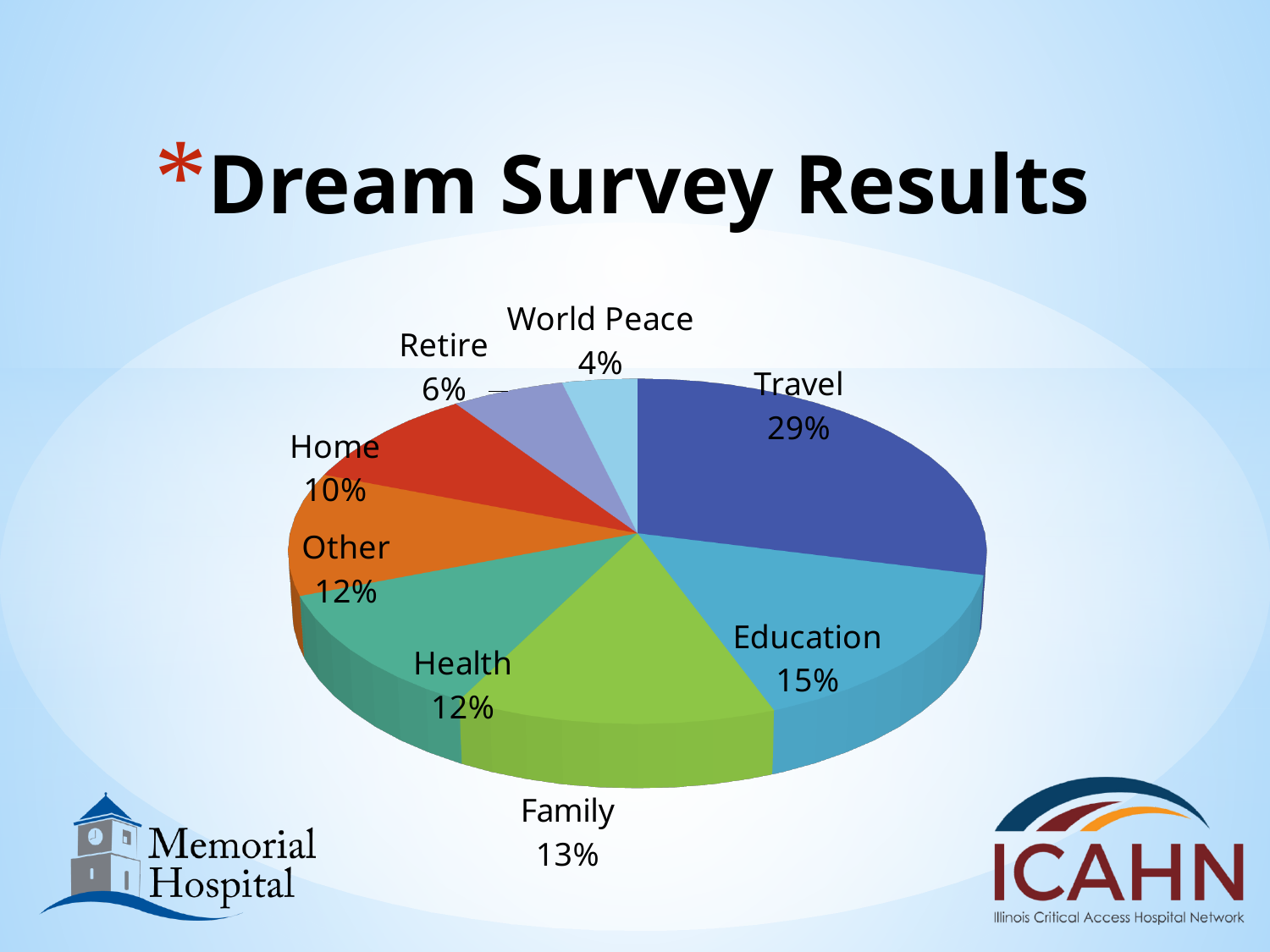
Which has a larger share, Education or Family? Education How many categories are shown in the pie chart? 8 What is the title of the slide containing the chart? Dream Survey Results What kind of chart is shown on the slide? Pie chart What percentage of the pie is Travel? 29% Which category has the smallest share of the pie? World Peace What is the difference in percentage points between Family and Retire? 7 Which category has the largest share of the pie? Travel What is the difference in percentage points between Travel and Education? 14 What percentage of the pie is Education? 15% What percentage of the pie is World Peace? 4% What percentage of the pie is Home? 10%